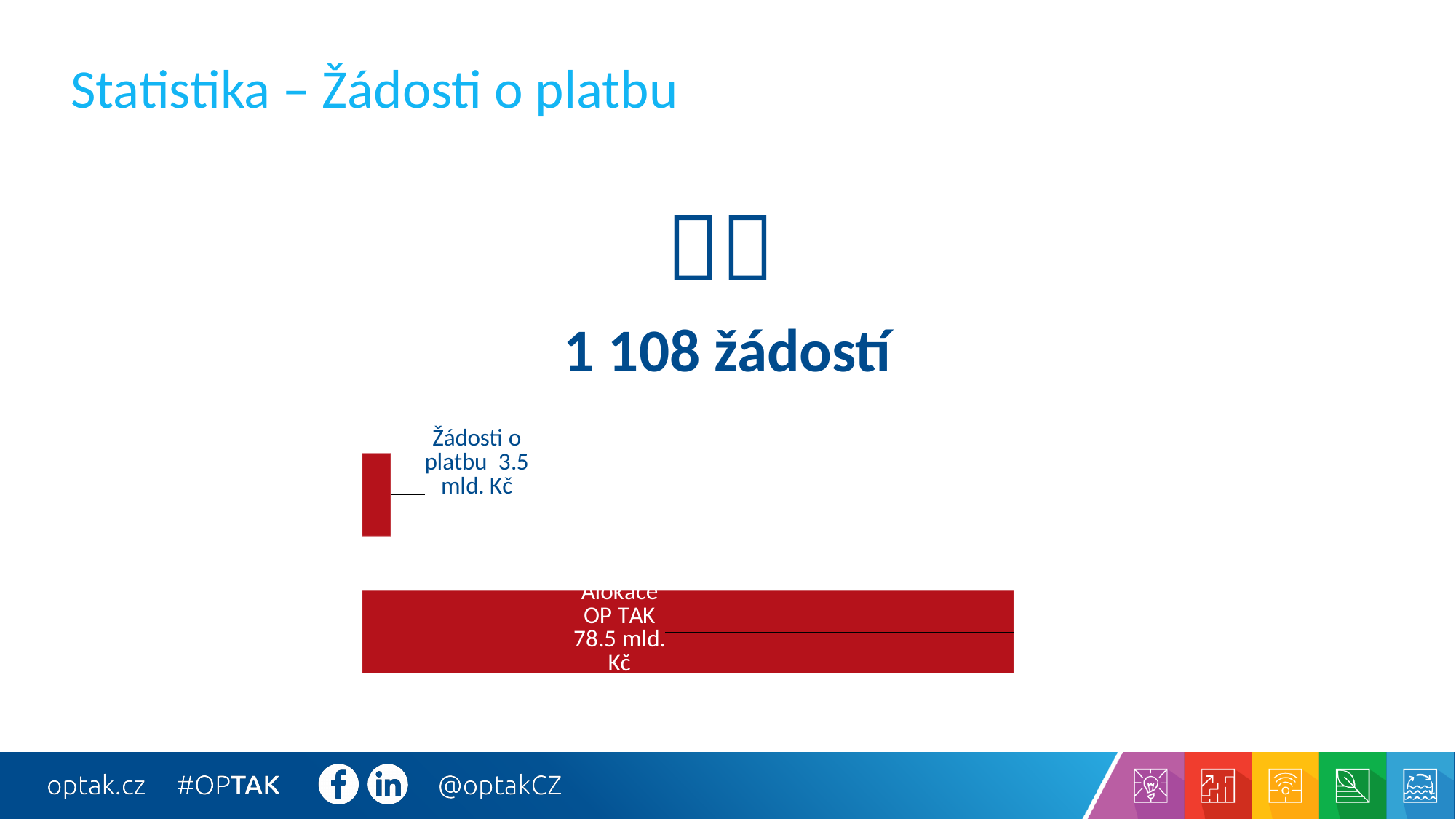
Which is larger, Alokace OP TAK or Žádosti o platbu? Alokace OP TAK Which bar is the longest? Alokace OP TAK What value is labelled for Žádosti o platbu? 3.5 mld. Kč What colour are the bars in the chart? red Which bar is the shortest? Žádosti o platbu What is the title of the slide containing the chart? Statistika – Žádosti o platbu What kind of chart is shown on the slide? bar chart How many bars does the chart show? 2 What value is labelled for Alokace OP TAK? 78.5 mld. Kč What is the difference between Alokace OP TAK and Žádosti o platbu? 75 mld. Kč How many žádostí are stated in the large text above the chart? 1 108 žádostí